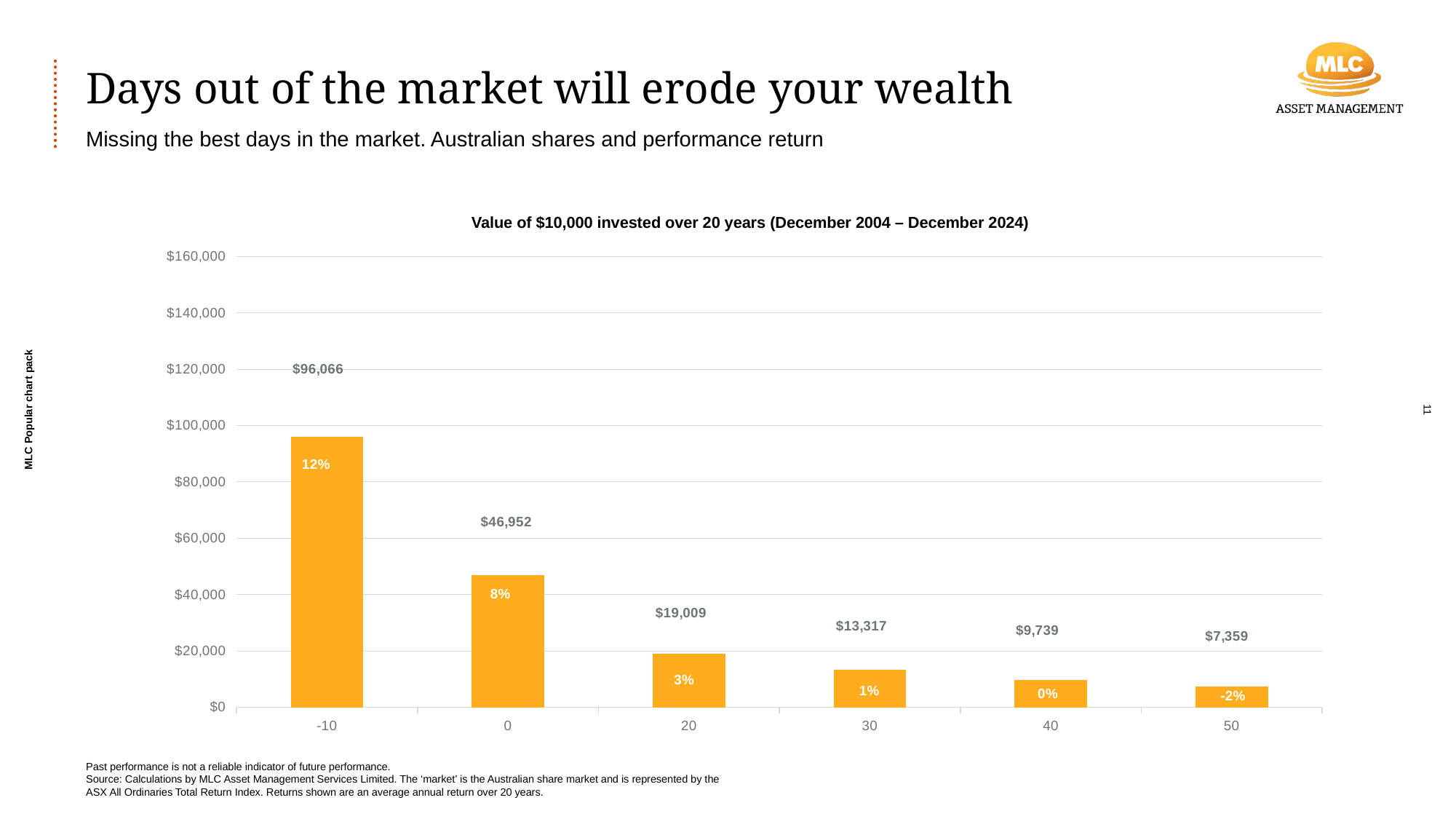
Which x-axis category has the highest value? -10 Which is larger, the value for "40" or the value for "30"? 30 What is the difference between the values for the "-10" and "0" categories? $49,114 What is the value of the bar labelled "-10" on the x axis? $96,066 What is the value of the bar labelled "50" on the x axis? $7,359 What is the value of the bar labelled "20" on the x axis? $19,009 What kind of chart is shown on the slide? Bar chart Is the value for the "0" category greater or less than $40,000? greater Which x-axis category has the lowest value? 50 How many bars are plotted in the chart? 6 What is the title of the chart? Value of $10,000 invested over 20 years (December 2004 – December 2024) What percentage is printed inside the bar labelled "30" on the x axis? 1%